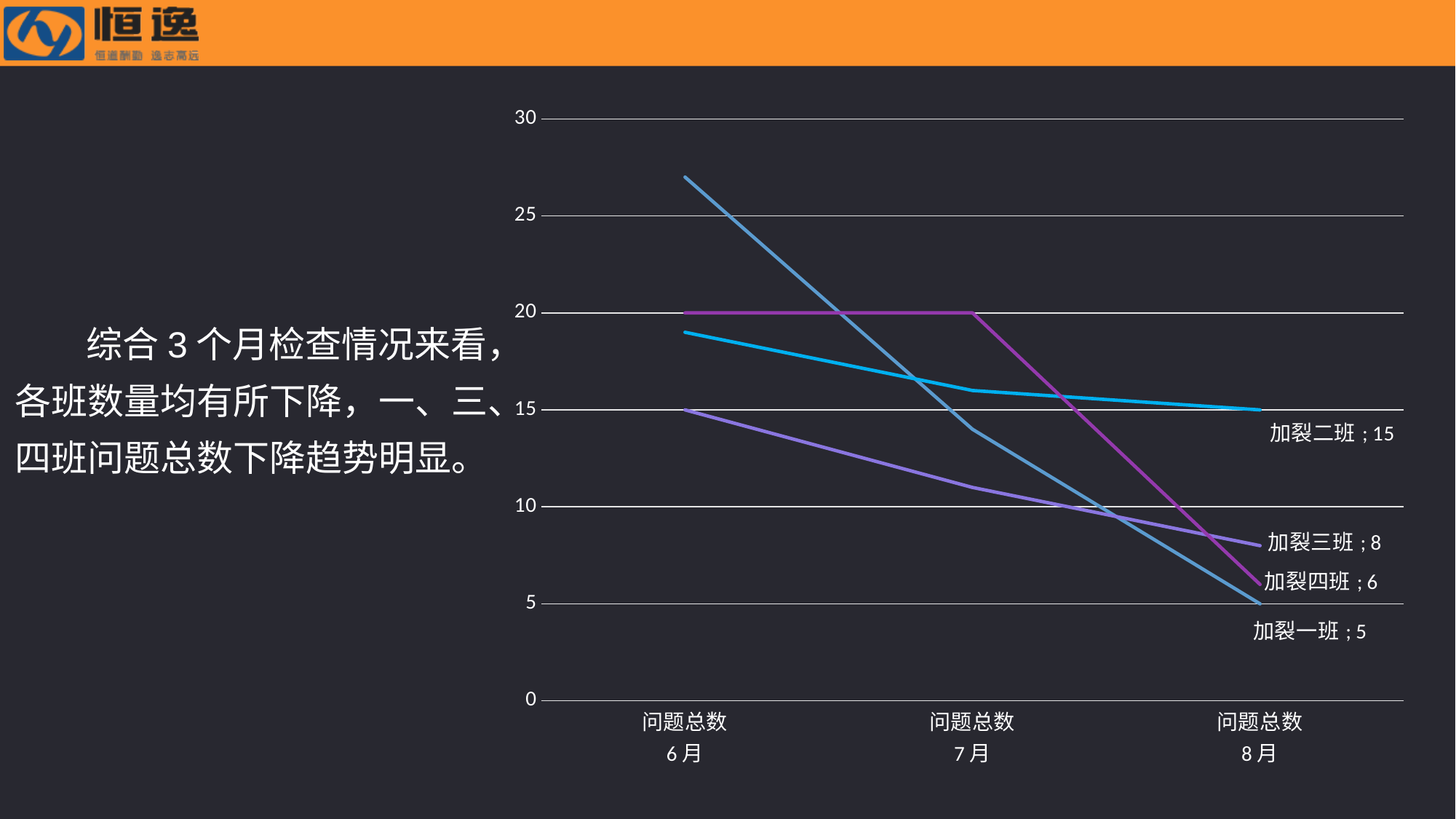
In 8月, which is larger, 加裂三班 or 加裂四班? 加裂三班 What is the difference between 加裂二班 and 加裂一班 in 8月? 10 Does the line for 加裂一班 rise or fall from 6月 to 8月? fall What is the value for 加裂二班 in 8月? 15 What is the value for 加裂三班 in 8月? 8 What kind of chart is shown on the slide? line chart Which series has the highest value in 8月? 加裂二班 What is the value for 加裂一班 in 8月? 5 Which series has the lowest value in 8月? 加裂一班 How many months are shown on the x axis? 3 What is the value for 加裂四班 in 8月? 6 Is the value for 加裂一班 in 6月 greater or less than 25? greater